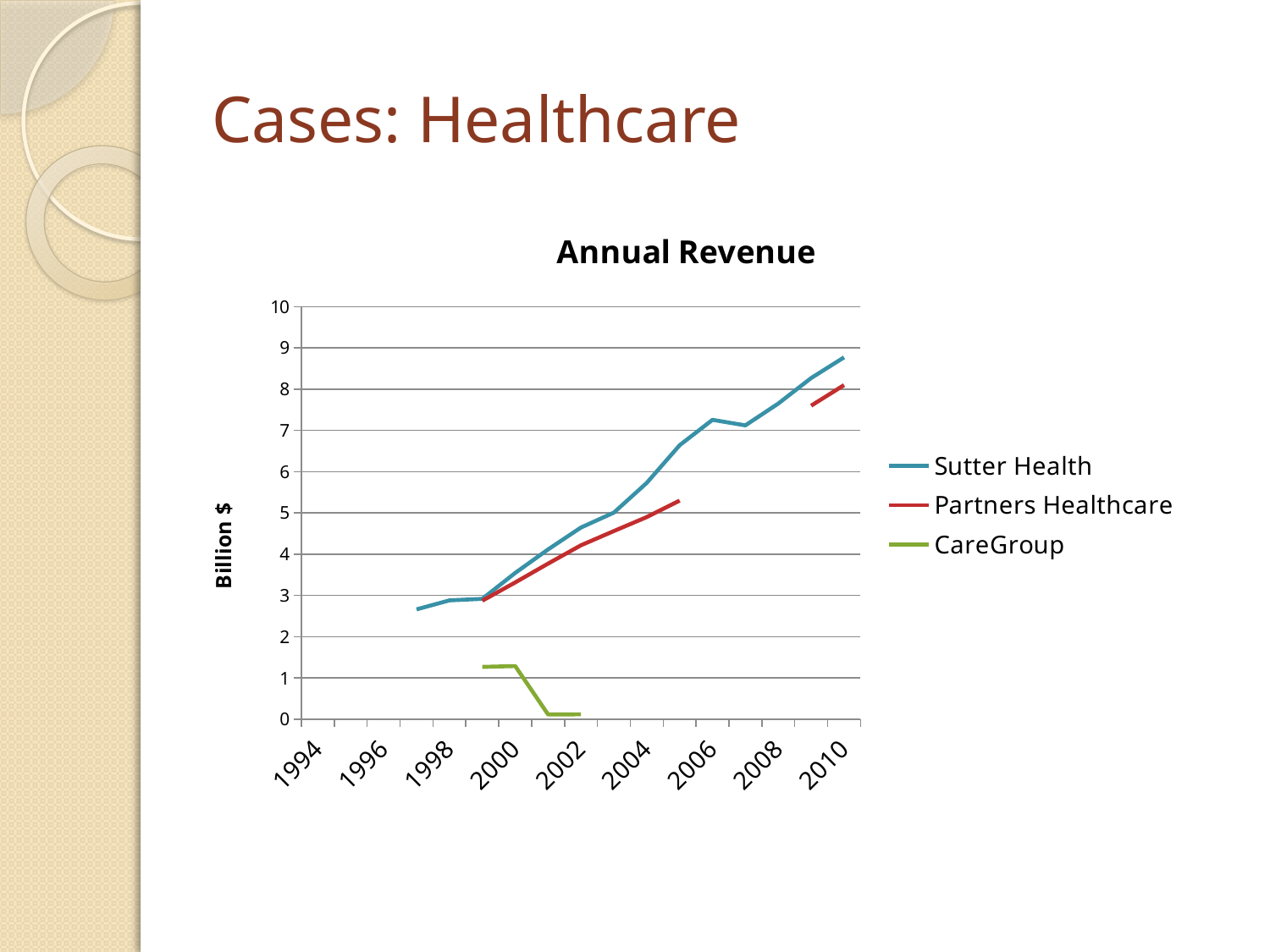
Is the value for Partners Healthcare in 2005 greater or less than 5? greater How many series does the legend of the Annual Revenue chart list? 3 Is the value for Sutter Health in 1998 greater or less than 3? less What kind of chart is shown on the slide? line chart Which series has the lowest values on the chart? CareGroup What is the label on the vertical axis of the chart? Billion $ Is the value for Sutter Health in 2010 greater or less than 8? greater Which series has the higher value in 2000, Sutter Health or CareGroup? Sutter Health Which series has the higher value in 2010, Sutter Health or Partners Healthcare? Sutter Health What is the title of the chart? Annual Revenue Does the Sutter Health line generally rise or fall from 1998 to 2010? rise